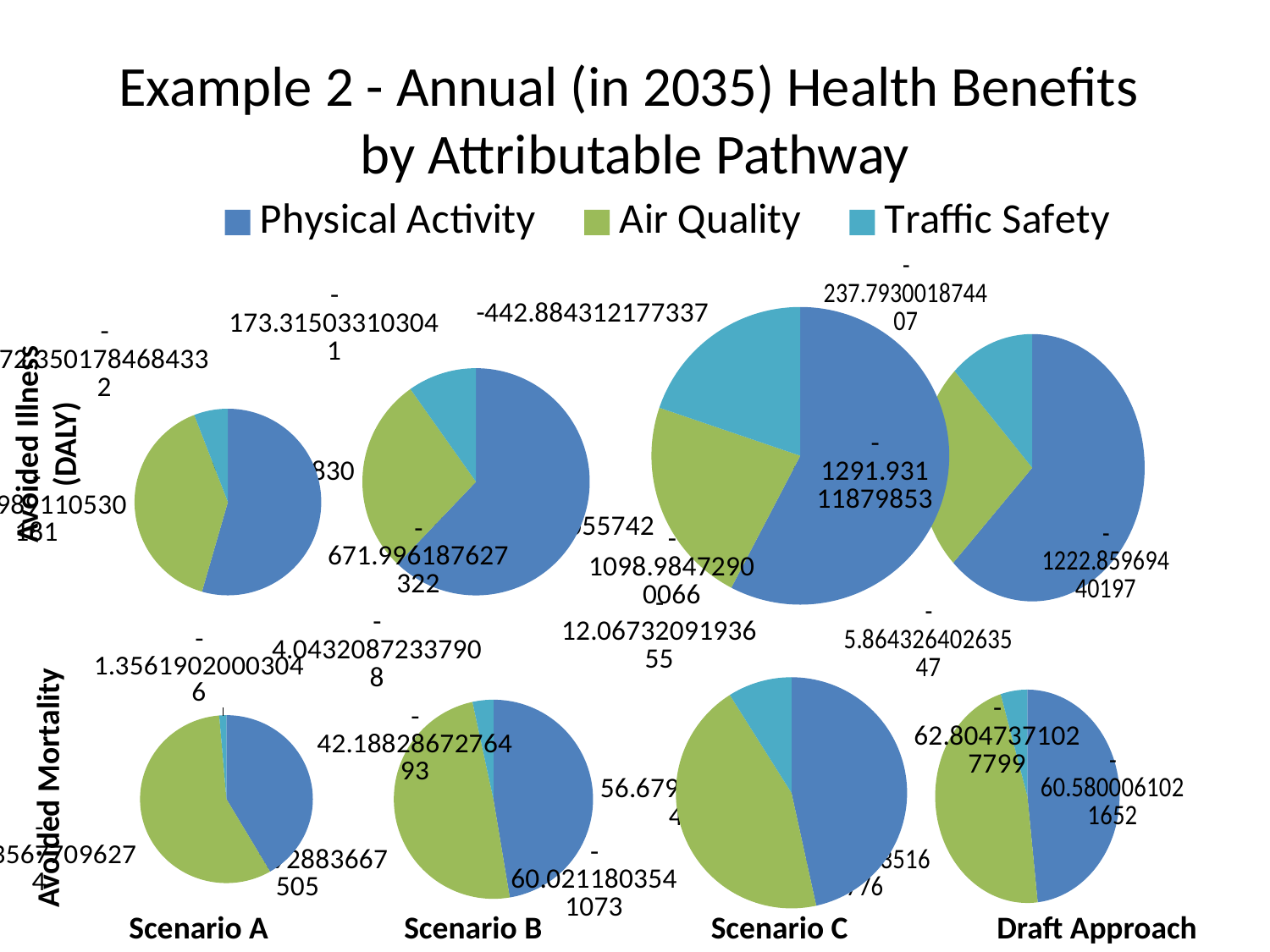
In the Avoided Mortality pie for Scenario A, which pathway has the smallest slice? Traffic Safety In the Avoided Mortality pie for Draft Approach, what is the value for Traffic Safety? -5.86432640263547 In the Avoided Illness (DALY) pie for Scenario C, what is the value for Traffic Safety? -442.884312177337 How many pie charts are on the slide? 8 In the Avoided Illness (DALY) pie for Scenario C, what is the value for Physical Activity? -1291.93111879853 In the Avoided Illness (DALY) pie for Scenario C, which pathway has the largest slice? Physical Activity How many series does the legend list? 3 What kind of charts are shown on the slide? Pie charts In the Avoided Illness (DALY) pie for Draft Approach, what is the value for Traffic Safety? -237.793001874407 Which colour represents Air Quality in the legend? Green